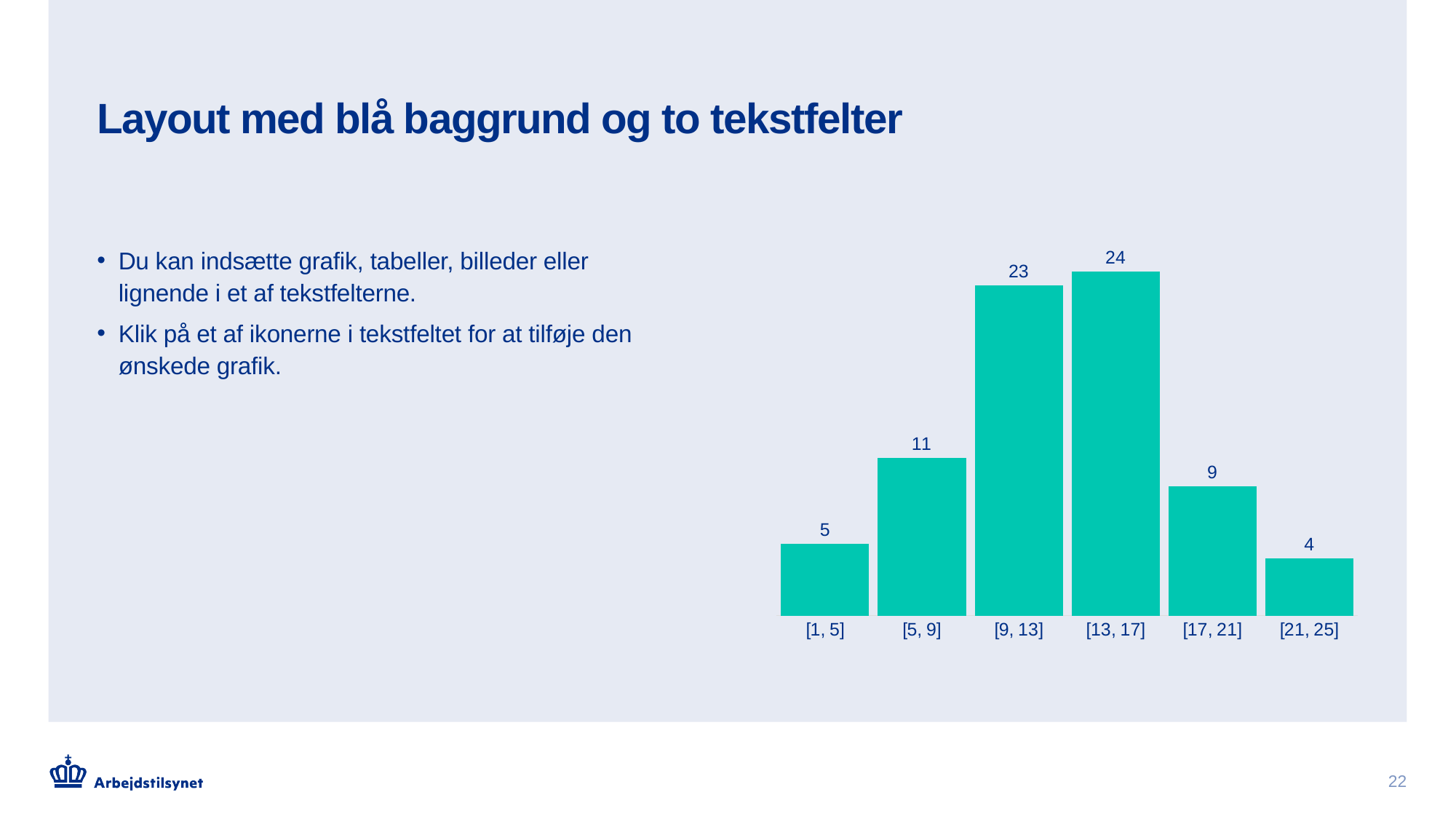
How many bins are shown on the x axis? 6 Which is larger, the value for [5, 9] or the value for [17, 21]? [5, 9] Which bin has the lowest value? [21, 25] What is the value for the [1, 5] bin? 5 What is the difference between the values for [9, 13] and [17, 21]? 14 What is the value for the [17, 21] bin? 9 What colour are the bars in the chart? Teal What is the difference between the values for [13, 17] and [5, 9]? 13 Which bin has the highest value? [13, 17] What is the value for the [9, 13] bin? 23 What kind of chart is shown on the slide? Bar chart Do the values rise or fall from [13, 17] to [21, 25]? Fall